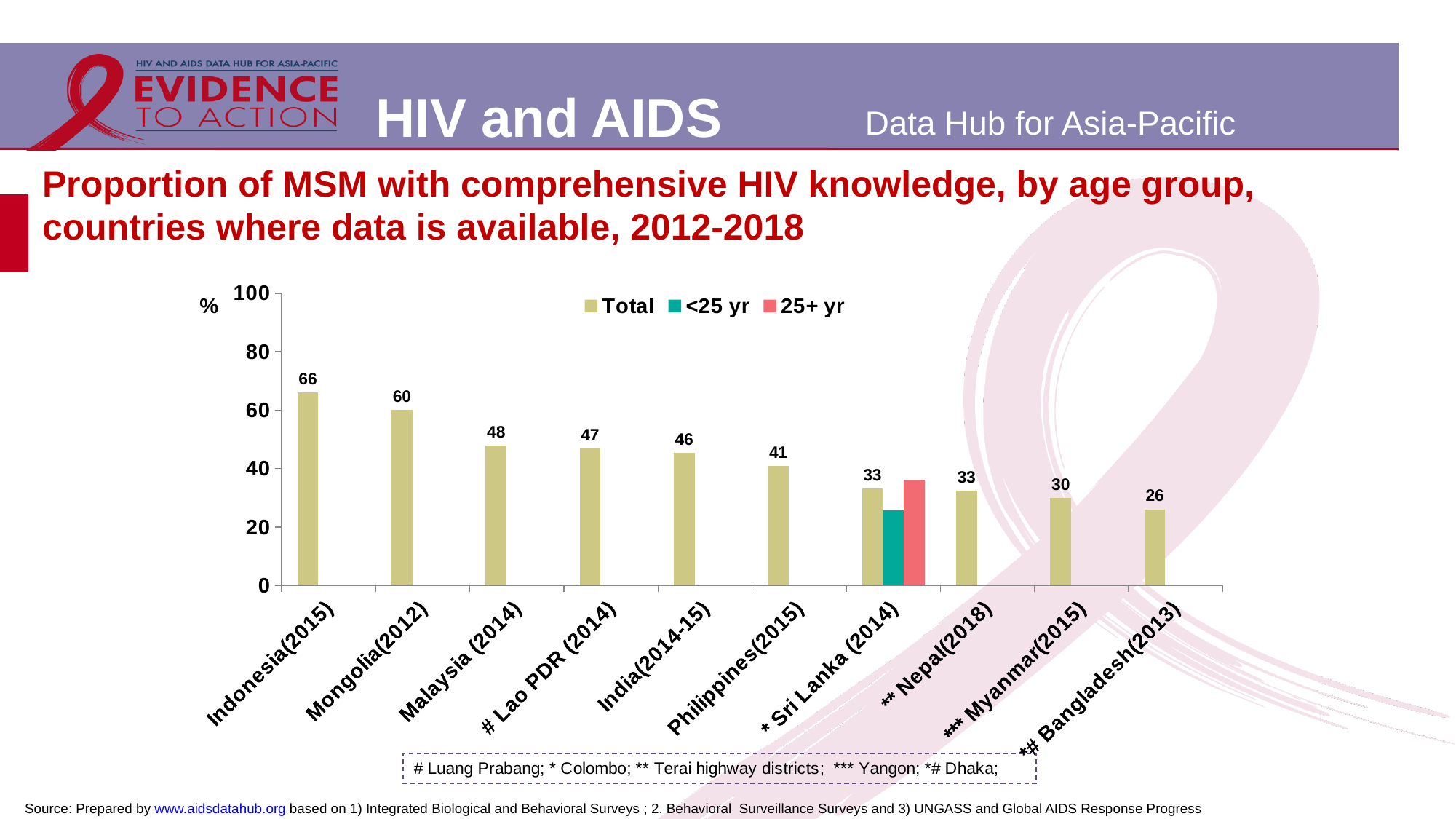
What is the Total value for *# Bangladesh(2013)? 26 Is the <25 yr value for * Sri Lanka (2014) greater or less than 40? less What is the Total value for Indonesia(2015)? 66 What is the Total value for Philippines(2015)? 41 How many series does the legend list? 3 Is the 25+ yr value for * Sri Lanka (2014) greater or less than 20? greater How many countries are shown on the x axis? 10 Which has a larger Total value, Malaysia (2014) or India(2014-15)? Malaysia (2014) Which country has the lowest Total value? *# Bangladesh(2013) Which country has the highest Total value? Indonesia(2015) What is the difference between the Total values for Mongolia(2012) and *** Myanmar(2015)? 30 Which country is the only one with <25 yr and 25+ yr bars shown? * Sri Lanka (2014)